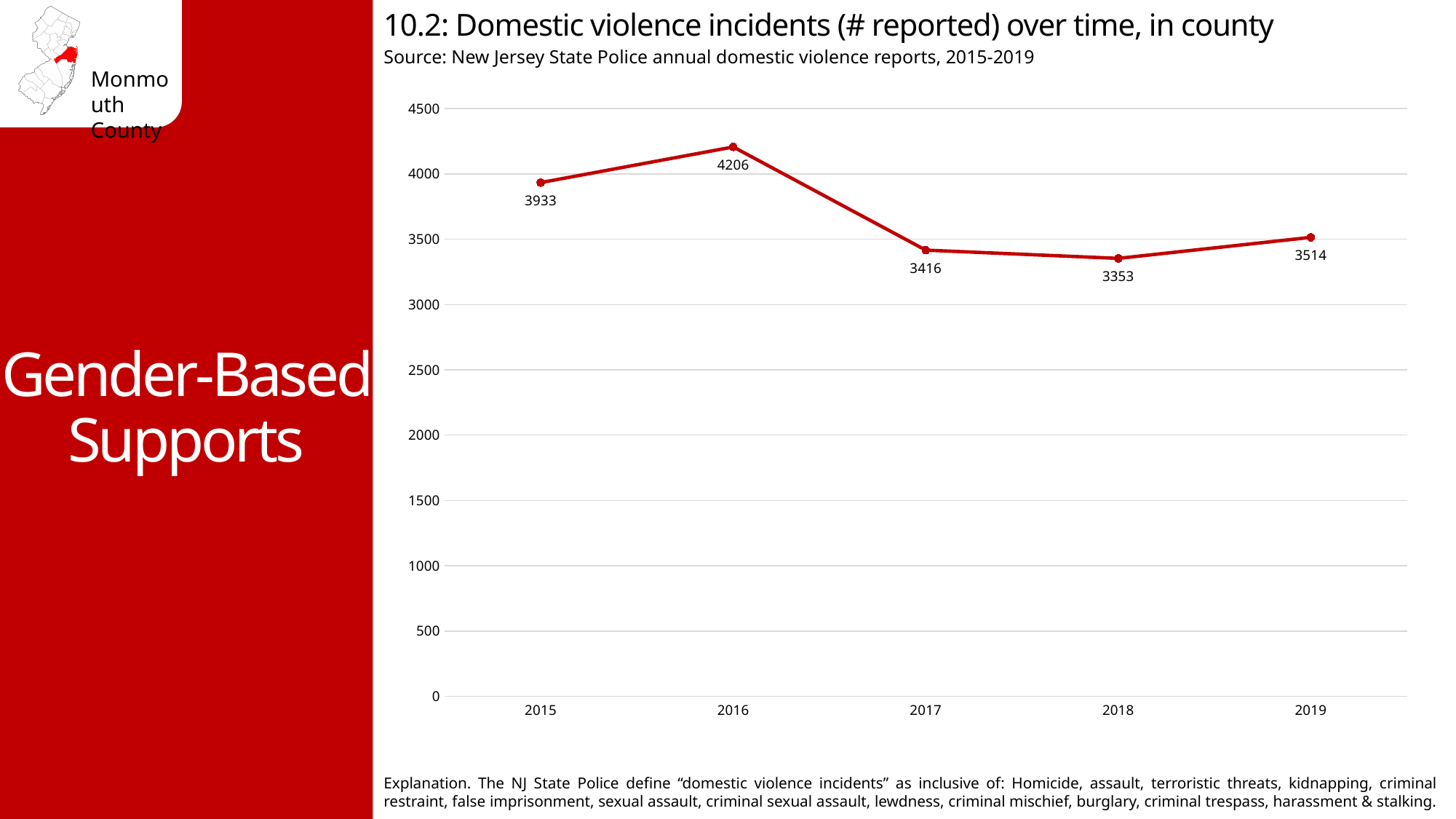
Did the number of reported incidents rise or fall from 2016 to 2018? fall Which year had more reported incidents, 2017 or 2019? 2019 What is the difference between the number of incidents reported in 2016 and in 2017? 790 How many domestic violence incidents were reported in 2016? 4206 What kind of chart is shown on the slide? line chart What is the difference between the number of incidents reported in 2015 and in 2019? 419 Which year had the highest number of reported domestic violence incidents? 2016 Is the value for 2015 greater or less than 4000? less How many years are plotted on the chart? 5 How many domestic violence incidents were reported in 2018? 3353 Which year had the lowest number of reported domestic violence incidents? 2018 How many domestic violence incidents were reported in 2019? 3514